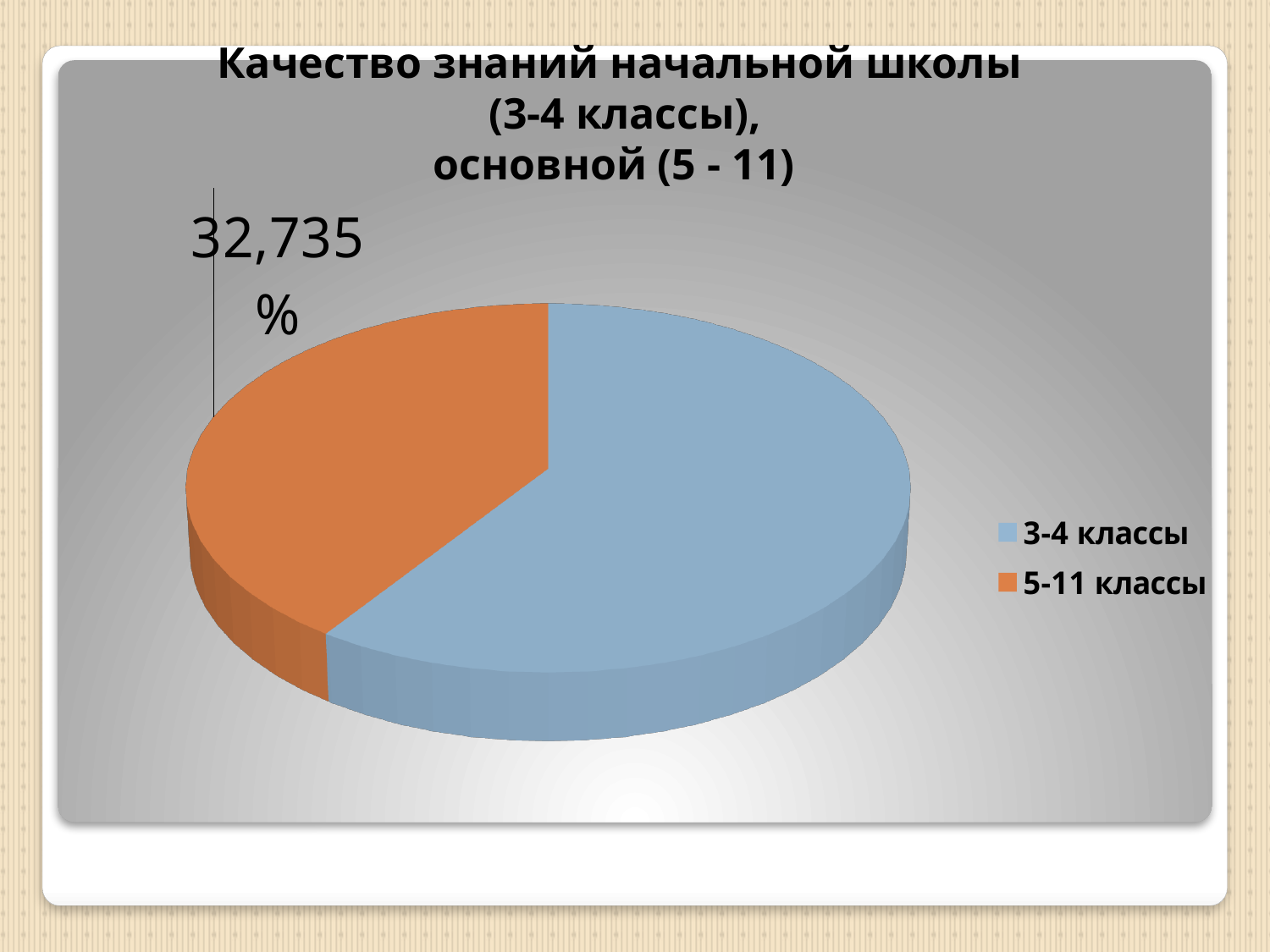
Which category has the largest slice of the pie? 3-4 классы How many slices does the pie chart have? 2 Which category is shown in blue? 3-4 классы Which category has the smallest slice of the pie? 5-11 классы What value is labelled on the slice for 5-11 классы? 32,735 % What colour is the slice for 5-11 классы? orange Which slice is larger, 3-4 классы or 5-11 классы? 3-4 классы How many entries does the legend list? 2 What is the title of the chart? Качество знаний начальной школы (3-4 классы), основной (5 - 11) What kind of chart is shown on the slide? pie chart